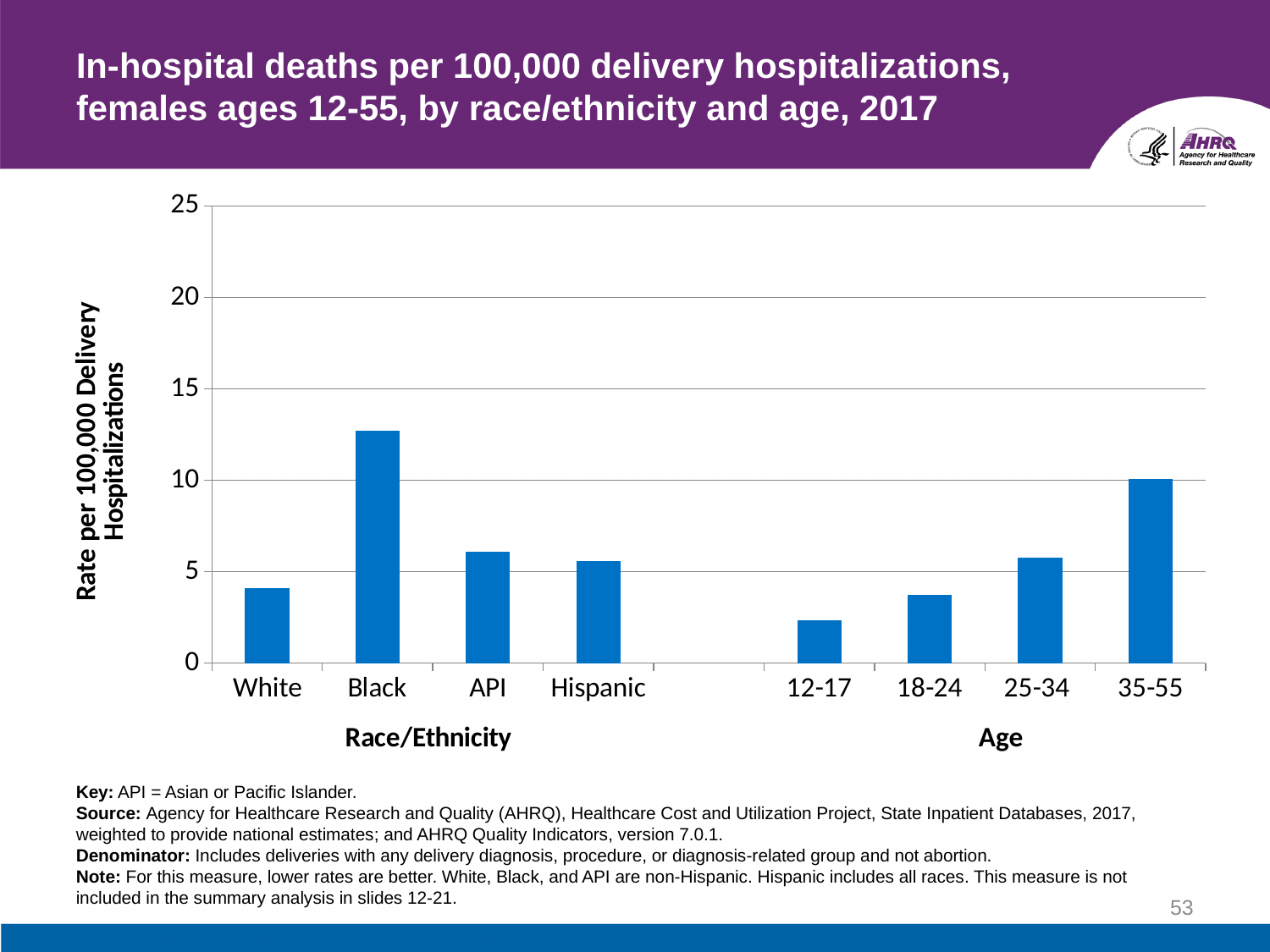
Which race/ethnicity group has the highest in-hospital death rate per 100,000 delivery hospitalizations? Black Is the rate for females ages 12-17 greater or less than 5 per 100,000 delivery hospitalizations? less Is the rate for White females greater or less than 5 per 100,000 delivery hospitalizations? less What type of chart is shown on the slide? Bar chart Is the rate for Black females greater or less than 10 per 100,000 delivery hospitalizations? greater Which age group has the highest in-hospital death rate per 100,000 delivery hospitalizations? 35-55 Which has a higher in-hospital death rate: females ages 18-24 or females ages 25-34? 25-34 Which race/ethnicity group has the lowest in-hospital death rate per 100,000 delivery hospitalizations? White Which age group has the lowest in-hospital death rate per 100,000 delivery hospitalizations? 12-17 Which has a higher in-hospital death rate: Black females or females ages 35-55? Black females How does the in-hospital death rate change across the age groups from 12-17 to 35-55? It rises